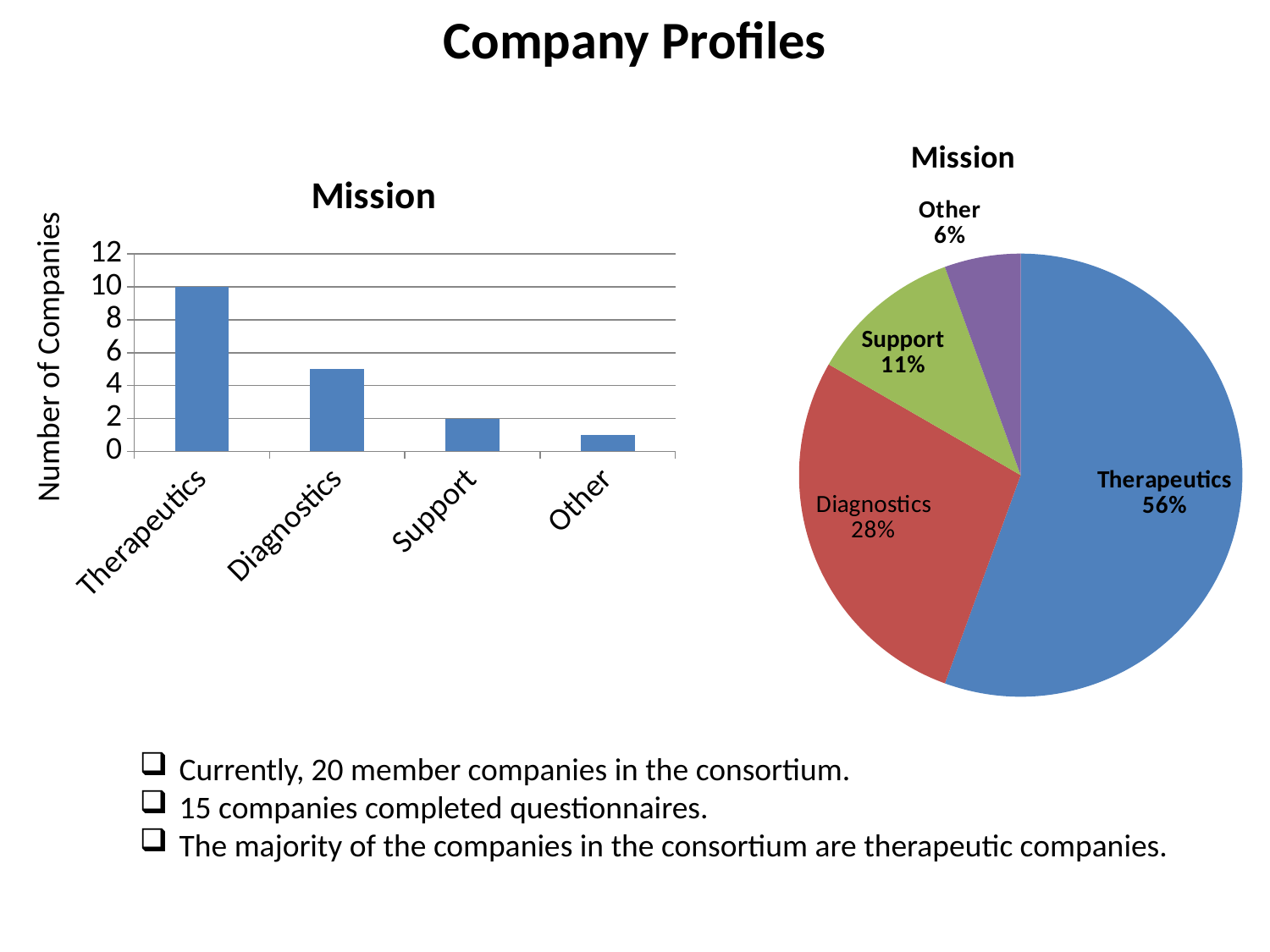
On the pie chart on the right, which is larger, the Support slice or the Other slice? Support On the bar chart on the left, which category has the lowest number of companies? Other On the bar chart on the left, what is the number of companies for Support? 2 On the bar chart on the left, which category has the highest number of companies? Therapeutics On the bar chart on the left, how many categories are shown on the x axis? 4 On the pie chart on the right, what share does Diagnostics have? 28% On the bar chart on the left, what is the number of companies for Therapeutics? 10 On the bar chart on the left, is the value for Diagnostics greater or less than 4? greater On the bar chart on the left, is the value for Other greater or less than 2? less What kind of chart is the chart on the left of the slide? Bar chart On the bar chart on the left, do the values rise or fall from Therapeutics to Other? Fall On the pie chart on the right, what is the difference between the Therapeutics share and the Support share? 45%